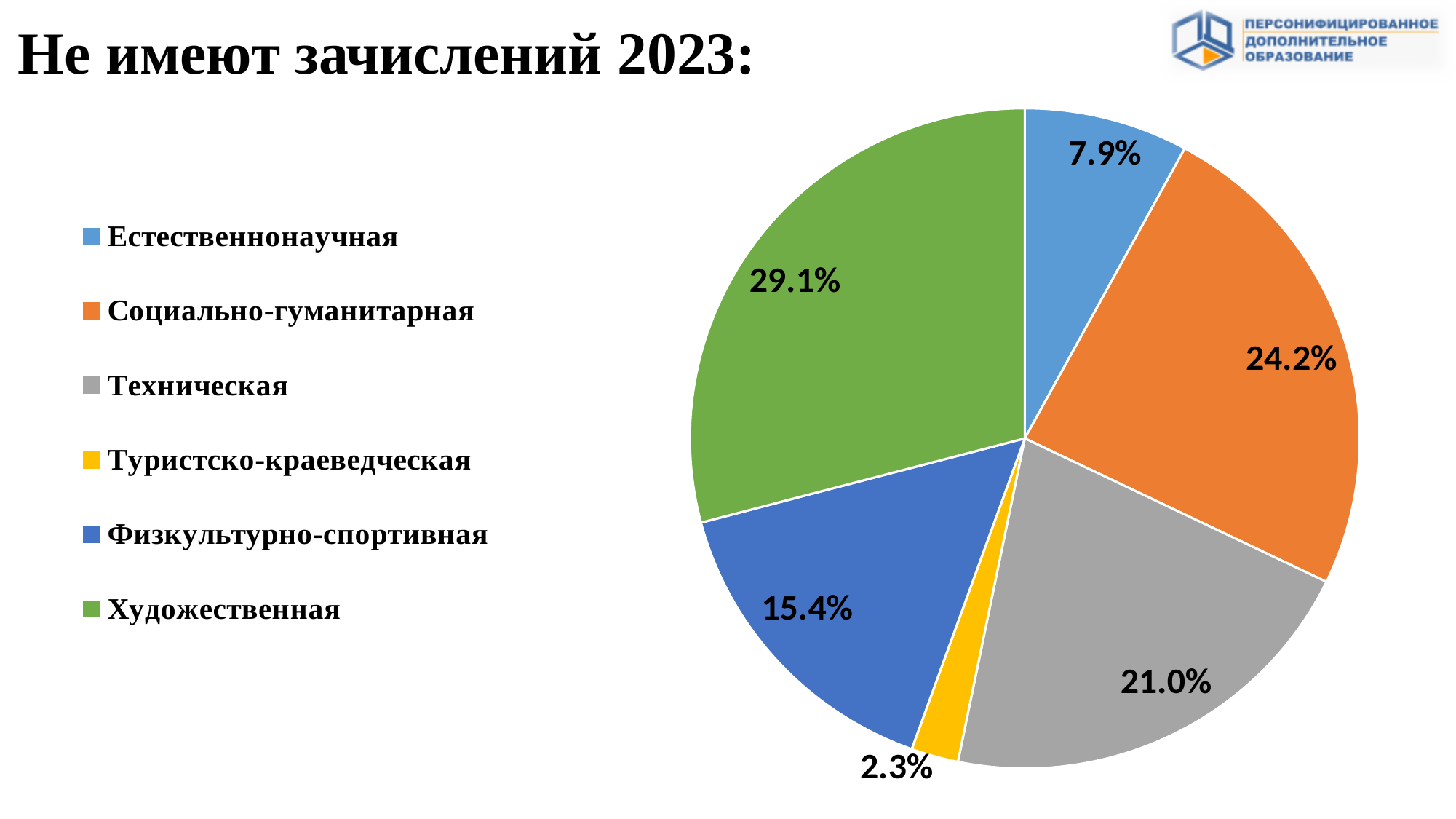
Which category has the largest share of the pie? Художественная Which is larger, the share for Техническая or the share for Физкультурно-спортивная? Техническая What share of the pie does Социально-гуманитарная have? 24.2% What share of the pie does Художественная have? 29.1% Which category has the smallest share of the pie? Туристско-краеведческая What share of the pie does Техническая have? 21.0% What share of the pie does Физкультурно-спортивная have? 15.4% How many categories does the pie chart have? 6 What share of the pie does Туристско-краеведческая have? 2.3% What share of the pie does Естественнонаучная have? 7.9% What kind of chart is shown on the slide? pie chart What is the difference in percentage points between Художественная and Социально-гуманитарная? 4.9